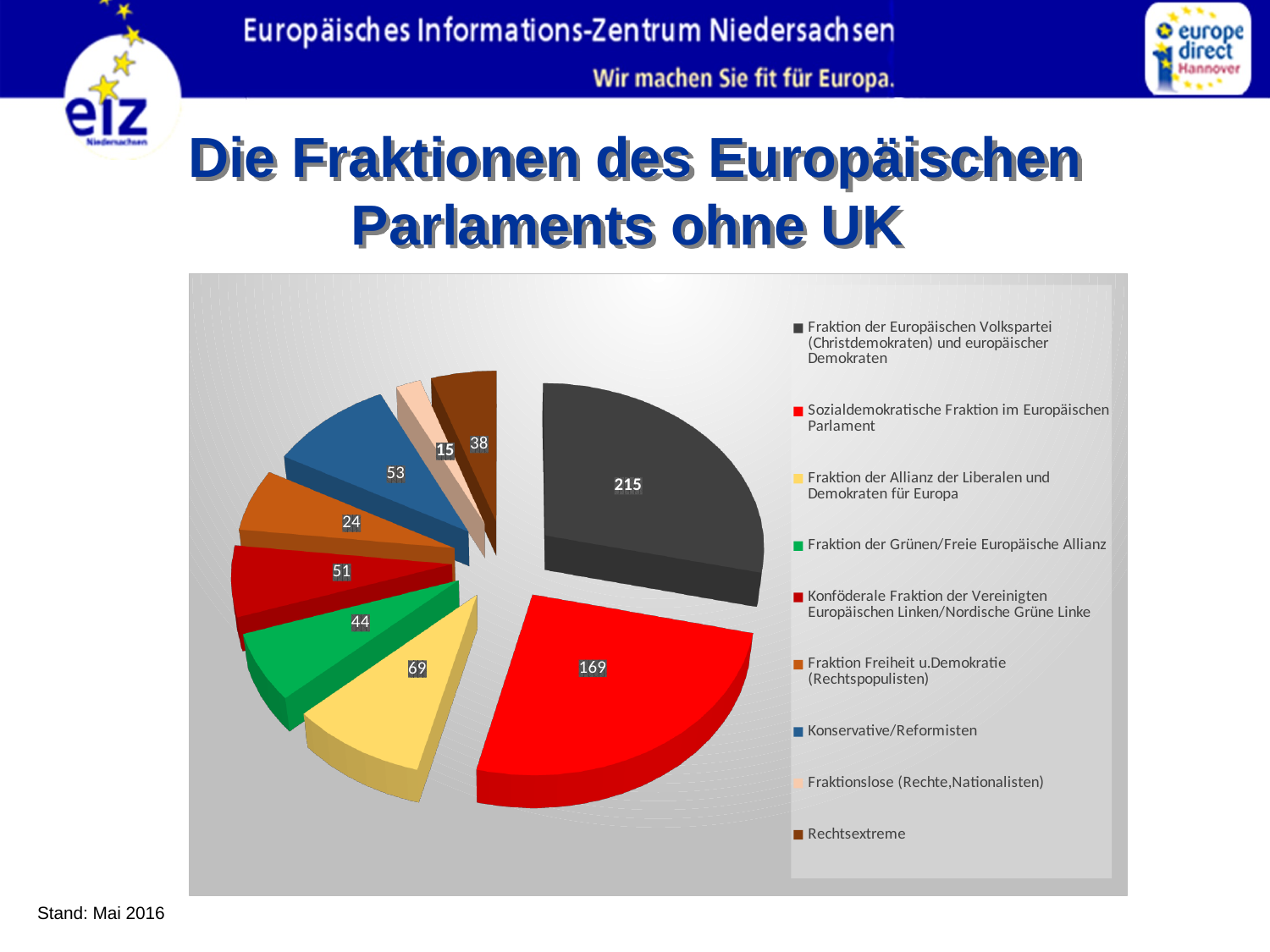
How many slices does the pie chart have? 9 What is the title of the slide containing the chart? Die Fraktionen des Europäischen Parlaments ohne UK What is the value for Fraktionslose (Rechte,Nationalisten)? 15 What is the value for the Fraktion der Allianz der Liberalen und Demokraten für Europa? 69 What type of chart is shown on the slide? pie chart What is the value for Konservative/Reformisten? 53 What is the difference between the value for the Sozialdemokratische Fraktion and the value for the Fraktion der Allianz der Liberalen und Demokraten für Europa? 100 What is the value for the Fraktion der Europäischen Volkspartei (Christdemokraten) und europäischer Demokraten? 215 Which group has the smallest slice of the pie? Fraktionslose (Rechte,Nationalisten) Which group has the largest slice of the pie? Fraktion der Europäischen Volkspartei (Christdemokraten) und europäischer Demokraten What is the value for the Sozialdemokratische Fraktion im Europäischen Parlament? 169 Which is larger: the value for Fraktion der Grünen/Freie Europäische Allianz or the value for Konföderale Fraktion der Vereinigten Europäischen Linken/Nordische Grüne Linke? Konföderale Fraktion der Vereinigten Europäischen Linken/Nordische Grüne Linke